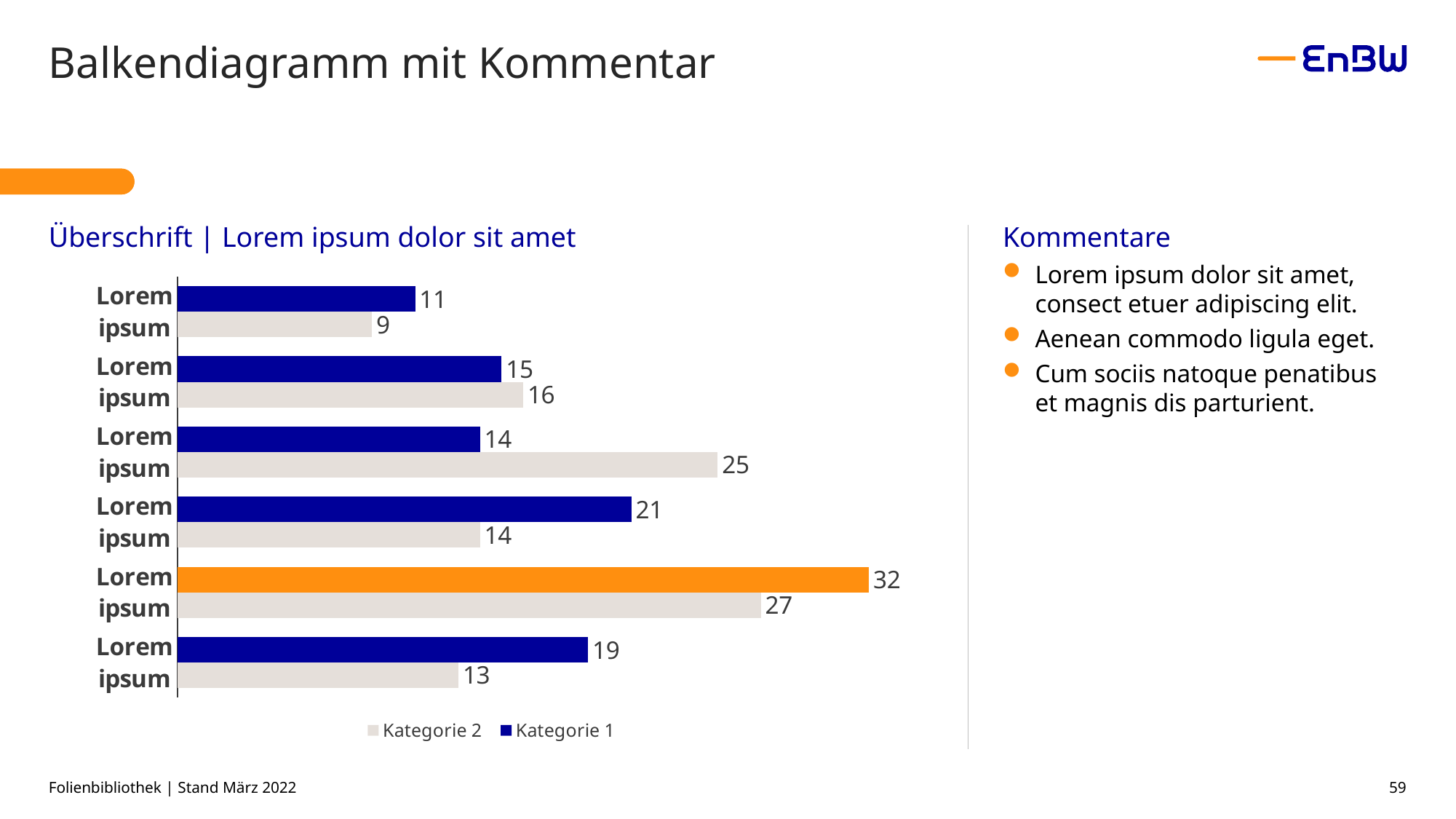
What is the difference between the Kategorie 1 values of the fourth and third categories from the top? 7 What is the Kategorie 2 value for the third category from the top? 25 What is the difference between the Kategorie 1 and Kategorie 2 values for the fifth category from the top? 5 What kind of chart is shown on the slide? bar chart What is the Kategorie 2 value for the topmost category? 9 For the bottom category, which is larger, the Kategorie 1 value or the Kategorie 2 value? Kategorie 1 What is the highest Kategorie 1 value shown on the chart? 32 How many categories are plotted on the chart? 6 Which bar on the chart is highlighted in orange? The Kategorie 1 bar of the fifth category from the top (value 32) How many series does the chart legend list? 2 What is the lowest Kategorie 2 value shown on the chart? 9 What is the Kategorie 1 value for the topmost category? 11